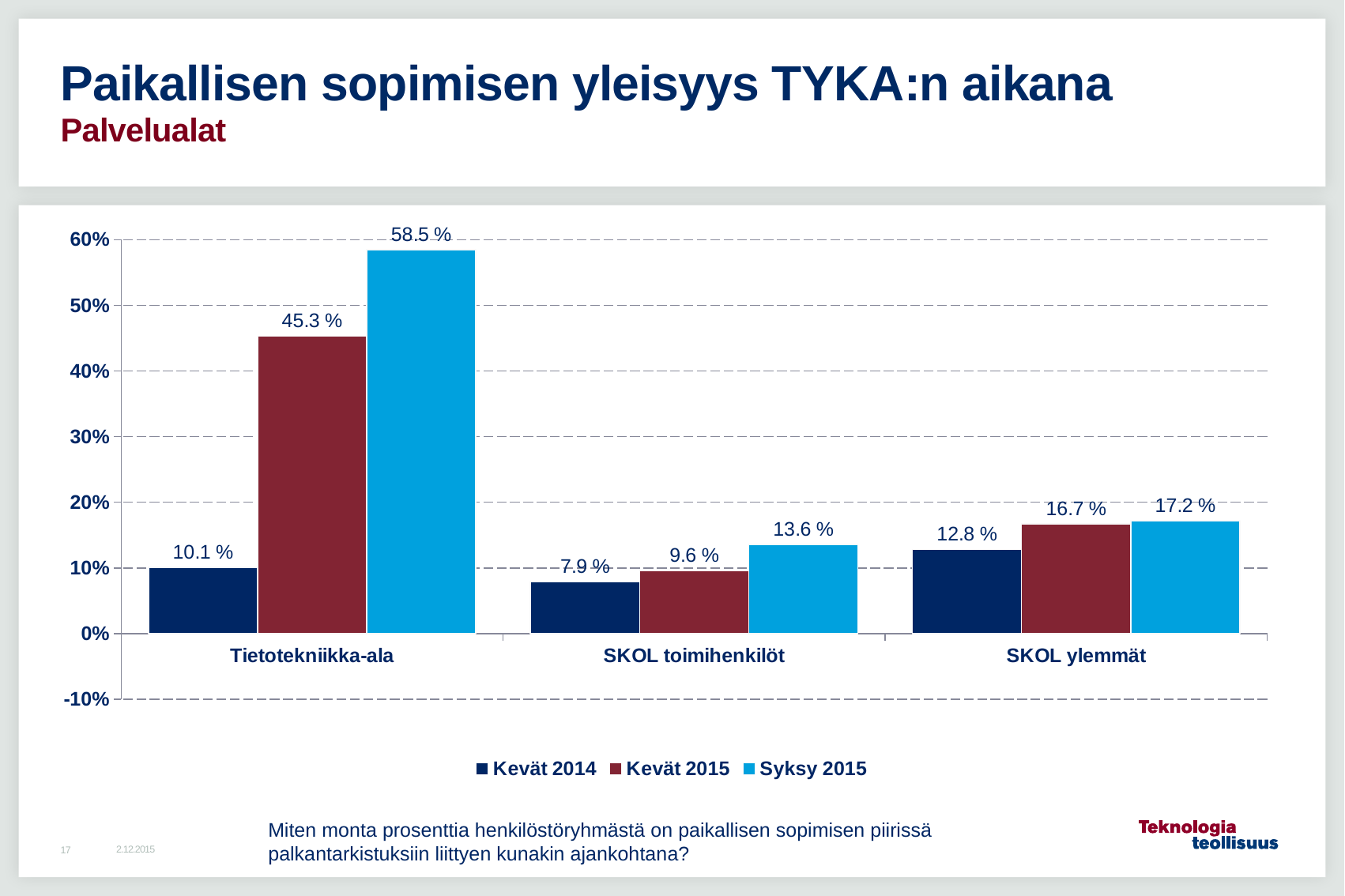
Which category has the highest value in the Kevät 2015 series? Tietotekniikka-ala What kind of chart is shown on the slide? Bar chart Which is larger: the Kevät 2014 value for SKOL ylemmät or the Kevät 2014 value for Tietotekniikka-ala? SKOL ylemmät Which category has the lowest value in the Syksy 2015 series? SKOL toimihenkilöt What is the difference between the Syksy 2015 and Kevät 2015 values for Tietotekniikka-ala? 13.2 % Is the Kevät 2015 value for Tietotekniikka-ala greater or less than 40%? greater What is the value for SKOL ylemmät in the Kevät 2015 series? 16.7 % What is the value for SKOL toimihenkilöt in the Kevät 2014 series? 7.9 % Do the values for SKOL toimihenkilöt rise or fall from Kevät 2014 to Syksy 2015? Rise What is the value for Tietotekniikka-ala in the Syksy 2015 series? 58.5 % How many series does the legend list? 3 How many categories are shown on the x axis? 3